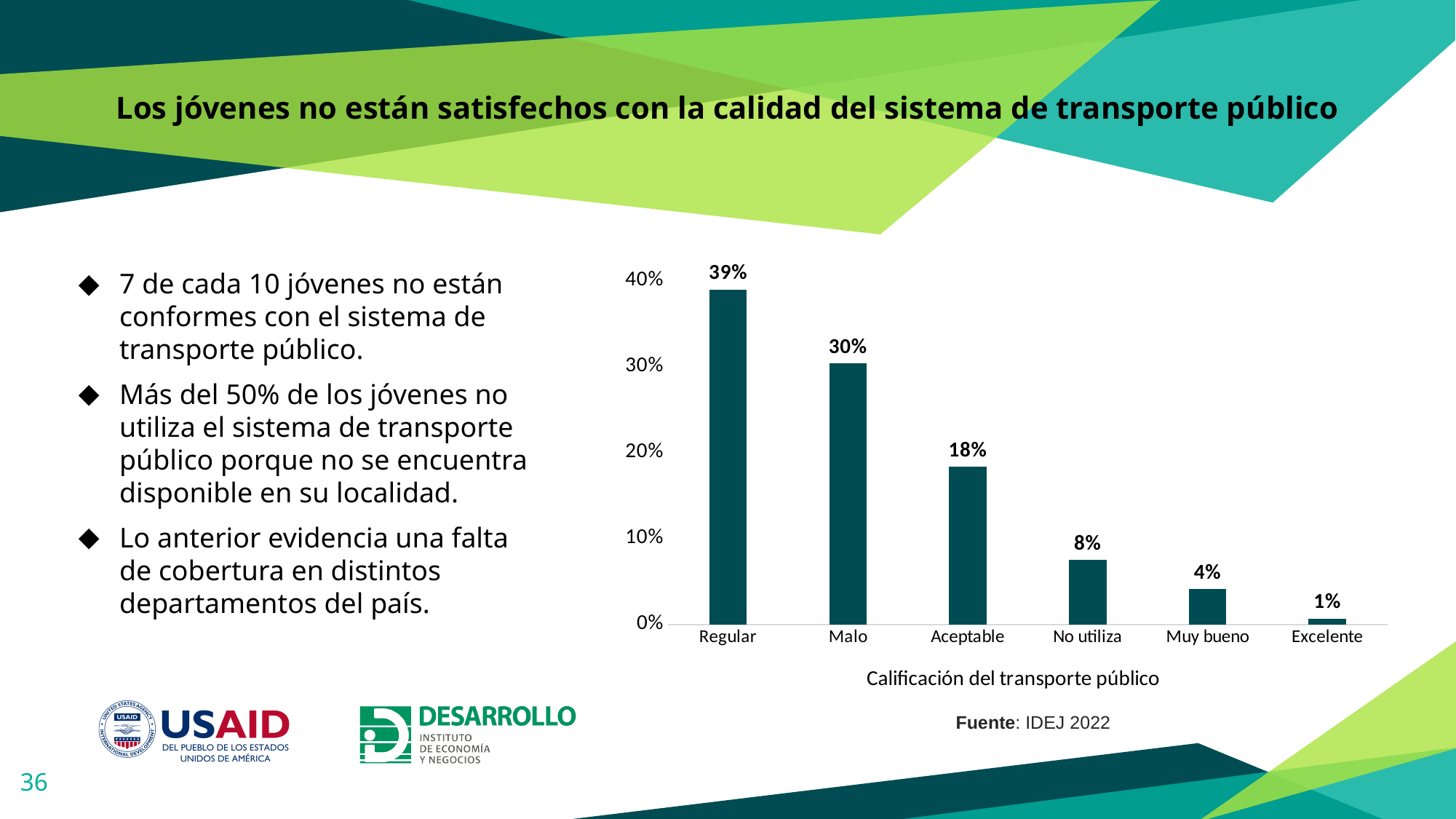
What is the x-axis title of the chart? Calificación del transporte público Which is larger, the value for Aceptable or the value for No utiliza? Aceptable What is the value for Regular? 39% Which category has the lowest value? Excelente What is the value for Malo? 30% What is the value for Excelente? 1% Which category has the highest value? Regular What is the difference between the values for Aceptable and Muy bueno? 14% What is the value for No utiliza? 8% What is the difference between the values for Regular and Malo? 9% How many categories are shown on the x axis? 6 What kind of chart is shown on the slide? Bar chart